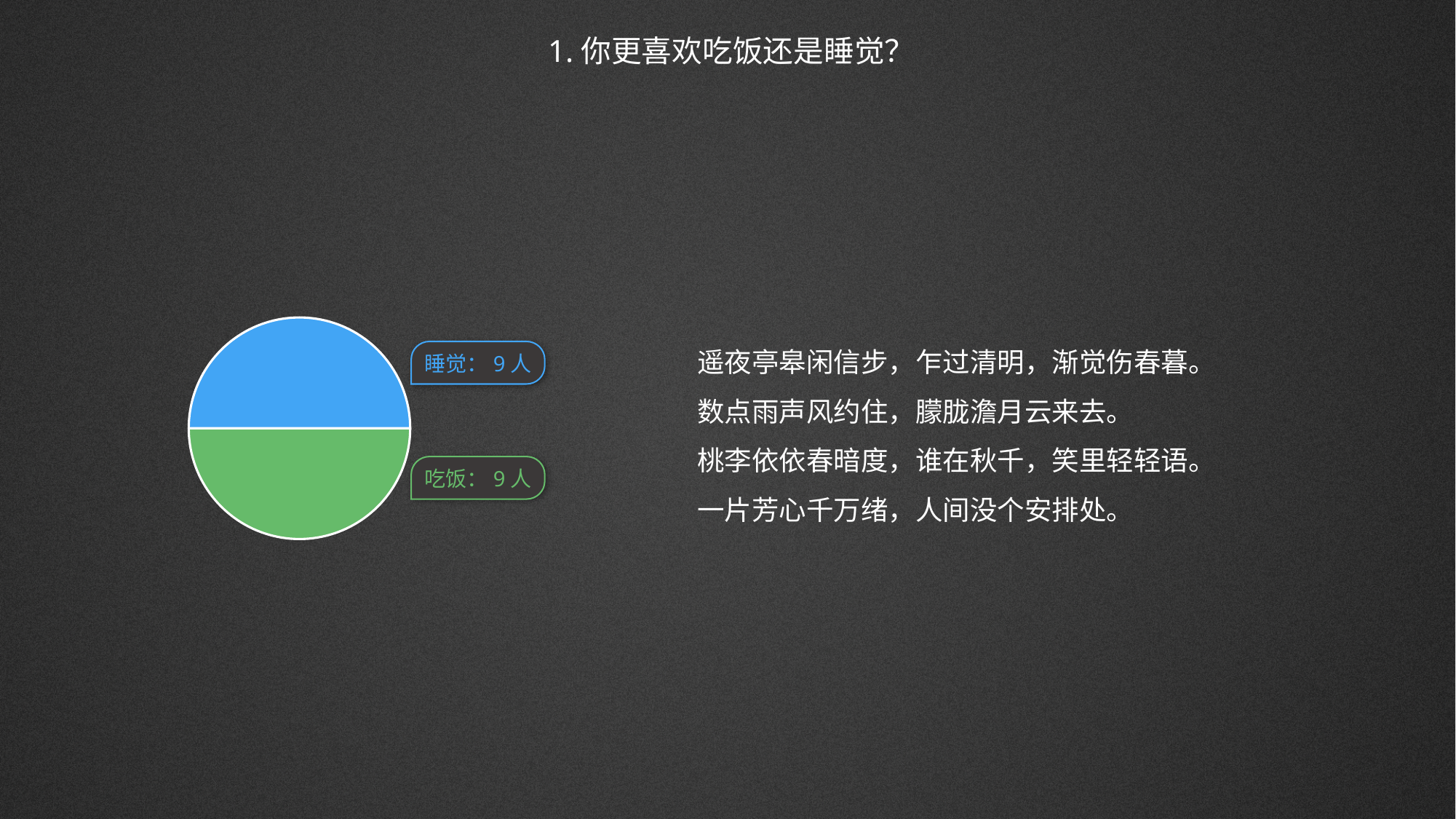
What is the question shown as the title above the pie chart? 1. 你更喜欢吃饭还是睡觉? What kind of chart is shown on the slide? pie chart How many slices does the pie chart have? 2 How many people chose 睡觉 in the pie chart? 9 人 How many people chose 吃饭 in the pie chart? 9 人 What share of the pie does the 睡觉 slice represent? 50% Is the value for 睡觉 larger than, smaller than, or equal to the value for 吃饭? equal What is the difference between the number of people who chose 睡觉 and the number who chose 吃饭? 0 What share of the pie does the 吃饭 slice represent? 50% What is the total number of people represented in the pie chart? 18 人 What colour is the 吃饭 slice in the pie chart? green